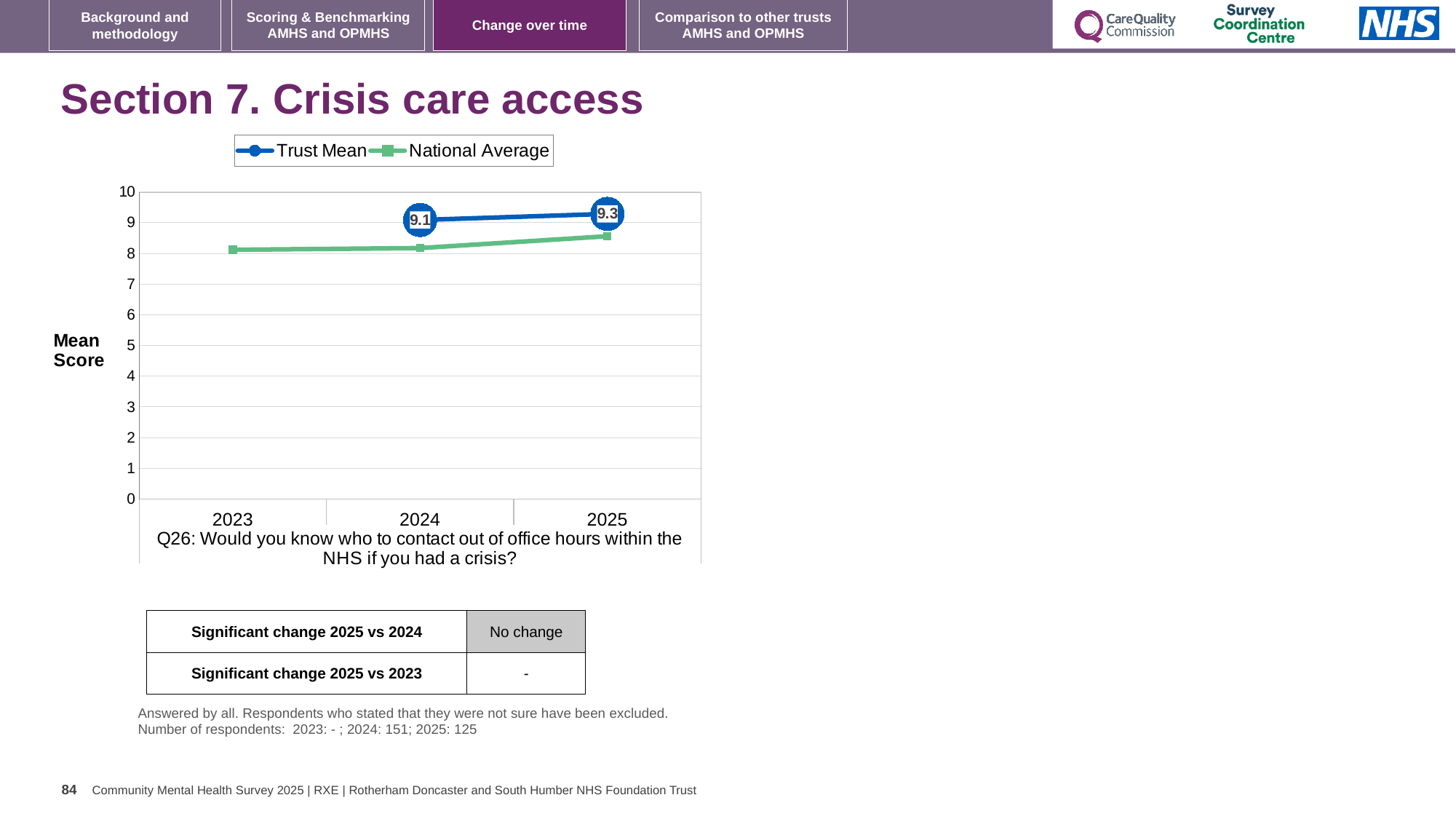
What kind of chart is shown on the slide? Line chart Does the Trust Mean rise or fall from 2024 to 2025? Rise Is the National Average value for 2025 greater or less than 9? less In which year is the Trust Mean highest? 2025 How many years are shown on the x axis of the chart? 3 Which is larger in 2025, the Trust Mean or the National Average? Trust Mean How many series does the chart legend list? 2 What is the label on the y axis of the chart? Mean Score Is the National Average value for 2024 greater or less than 7? greater What is the Trust Mean value for 2024? 9.1 What is the difference between the Trust Mean in 2025 and in 2024? 0.2 What is the Trust Mean value for 2025? 9.3